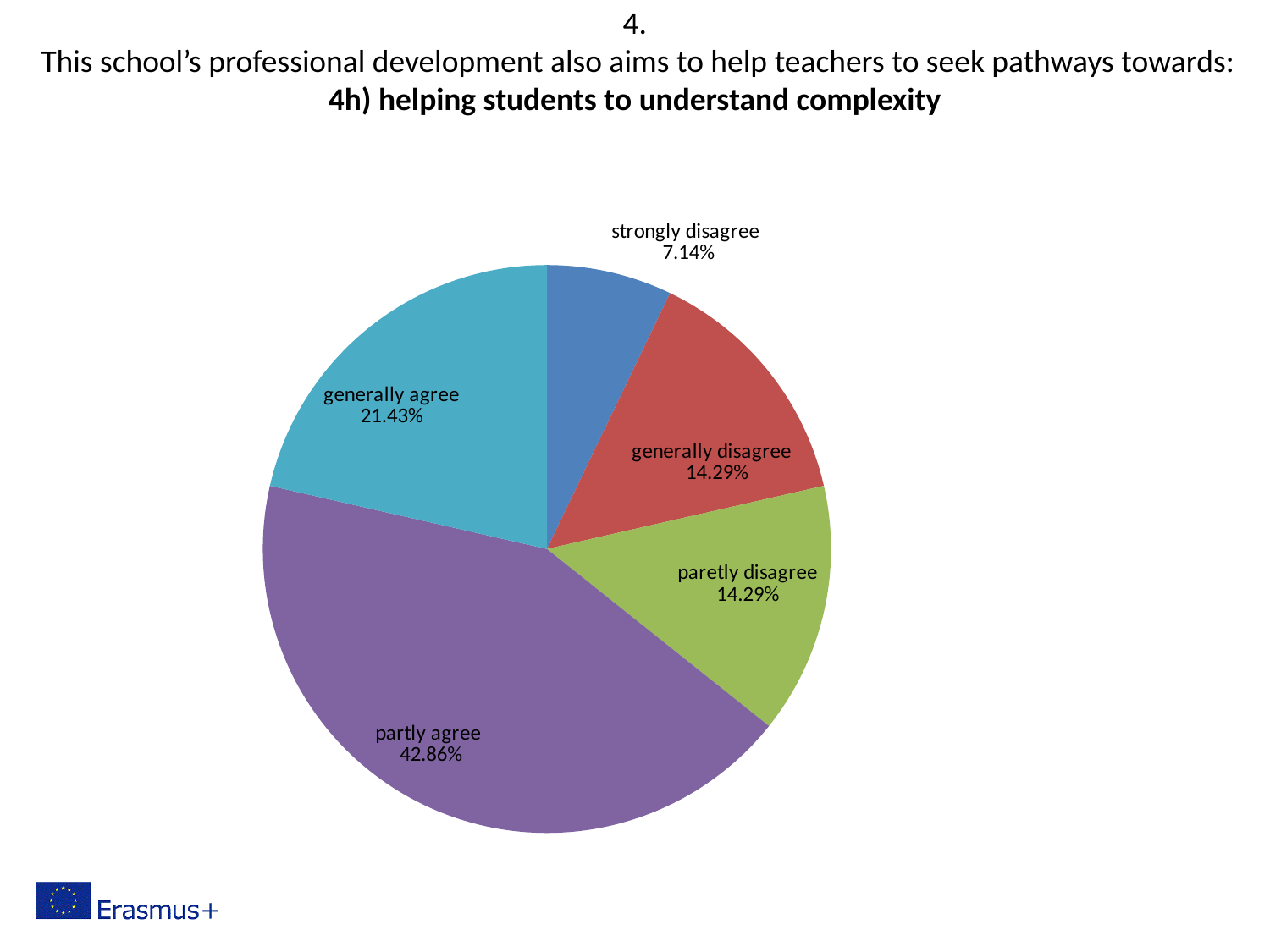
What is the difference between the "partly agree" and "generally agree" shares? 21.43% What kind of chart is shown on the slide? pie chart What is the value shown for "strongly disagree"? 7.14% What is the difference between the "generally agree" and "strongly disagree" shares? 14.29% What colour is the "partly agree" slice? purple What is the value shown for "generally disagree"? 14.29% Which category has the largest slice of the pie? partly agree How many slices does the pie chart have? 5 Which category has the smallest slice of the pie? strongly disagree Which is larger, the share for "generally agree" or the share for "generally disagree"? generally agree What share of the pie is labelled "partly agree"? 42.86% What is the value shown for "generally agree"? 21.43%